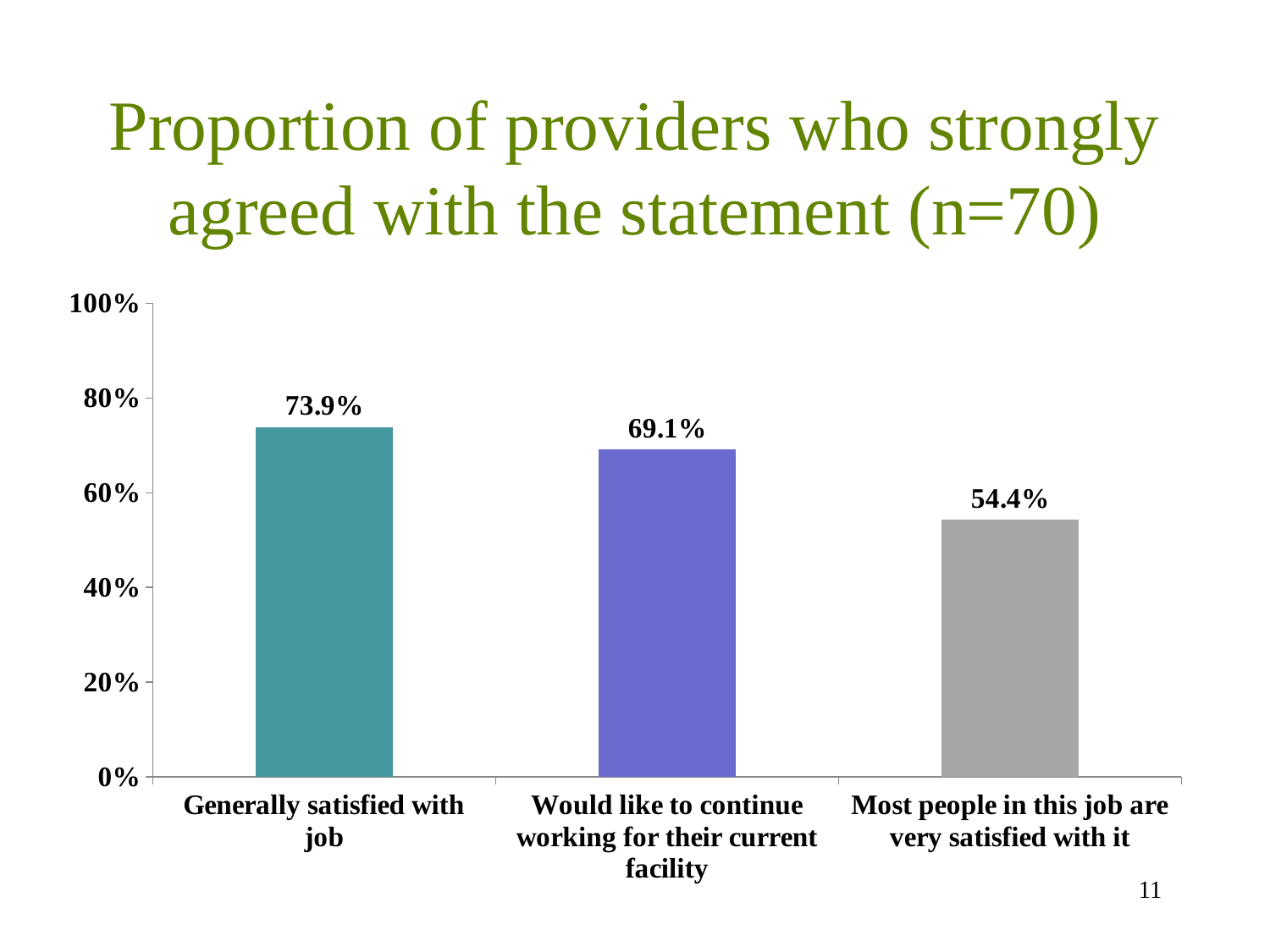
What proportion of providers strongly agreed that they are generally satisfied with their job? 73.9% What proportion of providers strongly agreed that they would like to continue working for their current facility? 69.1% Which statement had the highest proportion of providers strongly agreeing? Generally satisfied with job How many statements (categories) are shown in the chart? 3 What is the sample size (n) given in the chart title? 70 What is the difference in percentage points between 'Generally satisfied with job' and 'Most people in this job are very satisfied with it'? 19.5 percentage points Which statement had the lowest proportion of providers strongly agreeing? Most people in this job are very satisfied with it What is the difference in percentage points between 'Generally satisfied with job' and 'Would like to continue working for their current facility'? 4.8 percentage points What type of chart is shown on the slide? Bar chart Is the value for 'Most people in this job are very satisfied with it' greater or less than 60%? less Which is larger: the proportion for 'Would like to continue working for their current facility' or for 'Most people in this job are very satisfied with it'? Would like to continue working for their current facility What proportion of providers strongly agreed that most people in this job are very satisfied with it? 54.4%